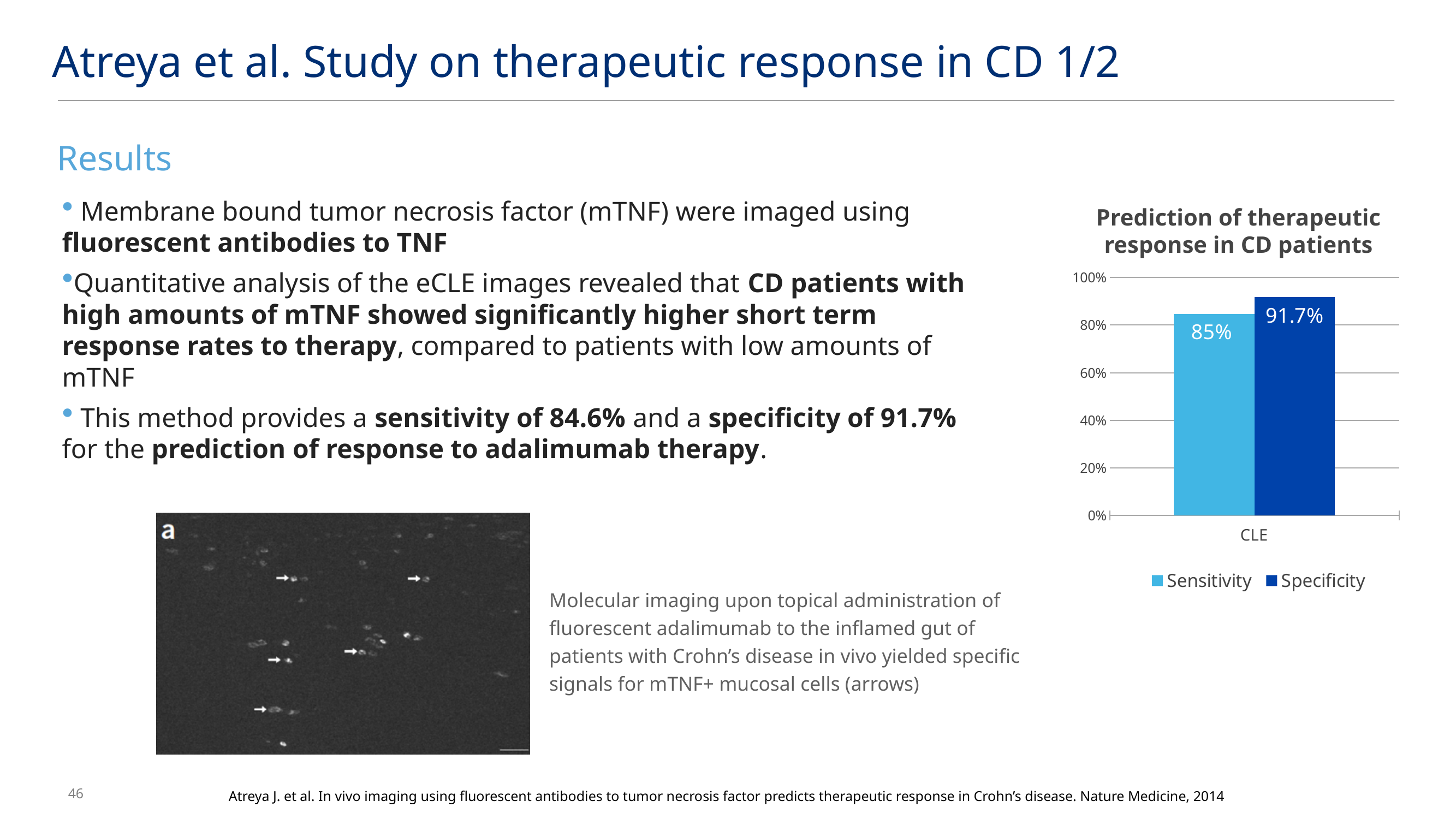
Is the Specificity value in the chart greater or less than 100%? less What is the Specificity value shown for CLE in the chart? 91.7% How many series does the chart legend list? 2 Which series has the lowest value in the chart? Sensitivity What kind of chart is shown on the slide? Bar chart Which series has the higher value in the chart, Sensitivity or Specificity? Specificity How many categories are shown on the x axis of the chart? 1 Is the Sensitivity value in the chart greater or less than 80%? greater What is the Sensitivity value shown for CLE in the chart? 85% What is the difference between the Specificity and Sensitivity values in the chart? 6.7% What is the title of the chart? Prediction of therapeutic response in CD patients What is the category label on the x axis of the chart? CLE